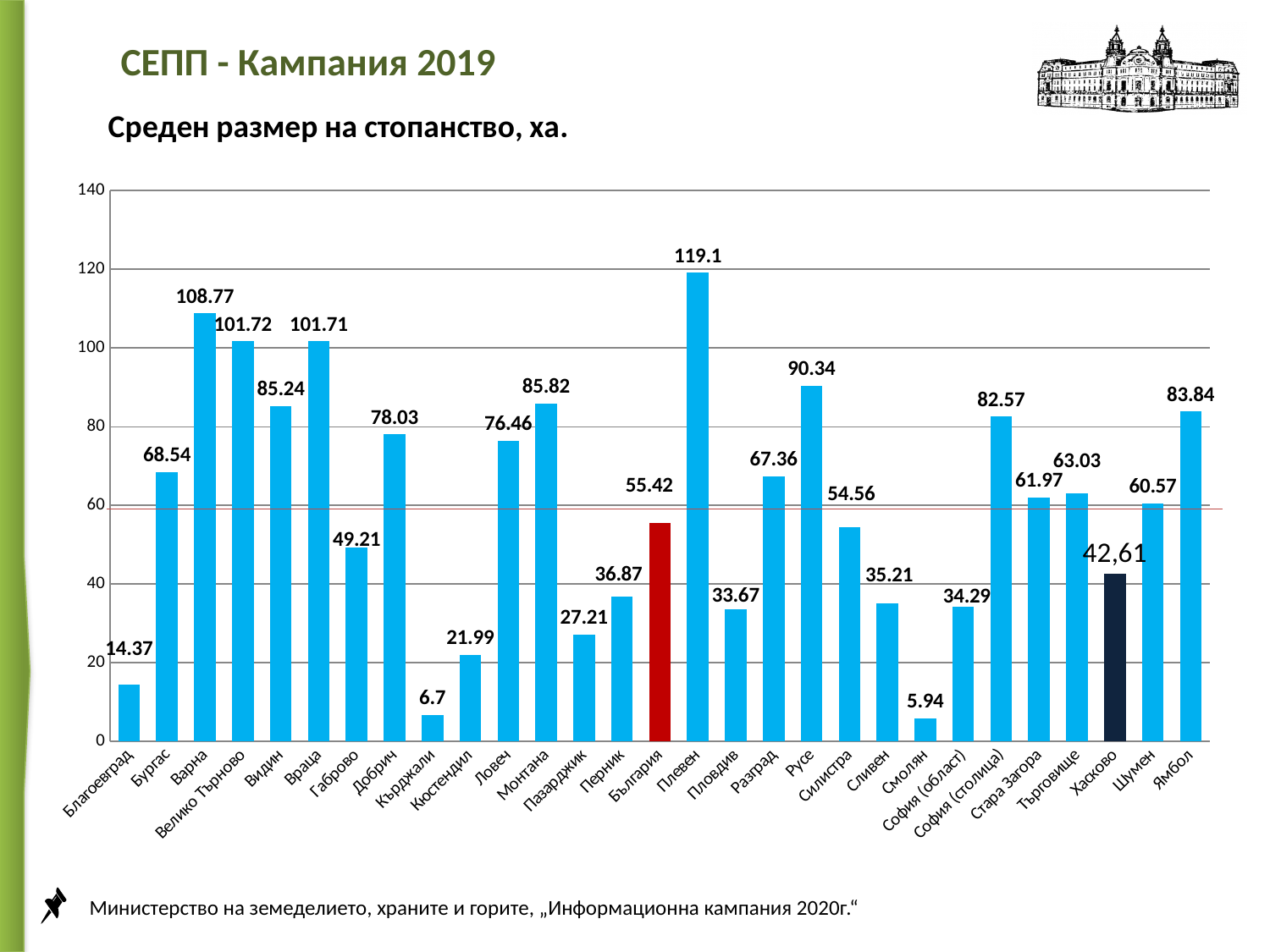
What is the difference between the values for Варна and Велико Търново? 7.05 Which is larger, the value for Русе or the value for Ямбол? Русе What kind of chart is shown on the slide? bar chart Is the value for Бургас greater or less than 60? greater What value is shown for България? 55.42 How many regions (categories) are shown on the chart? 29 What value is shown for Хасково? 42,61 What is the average farm size for Плевен? 119.1 Which category is shown with a red bar? България What is the difference between the values for Плевен and Русе? 28.76 Which region has the highest average farm size? Плевен Which region has the lowest average farm size? Смолян